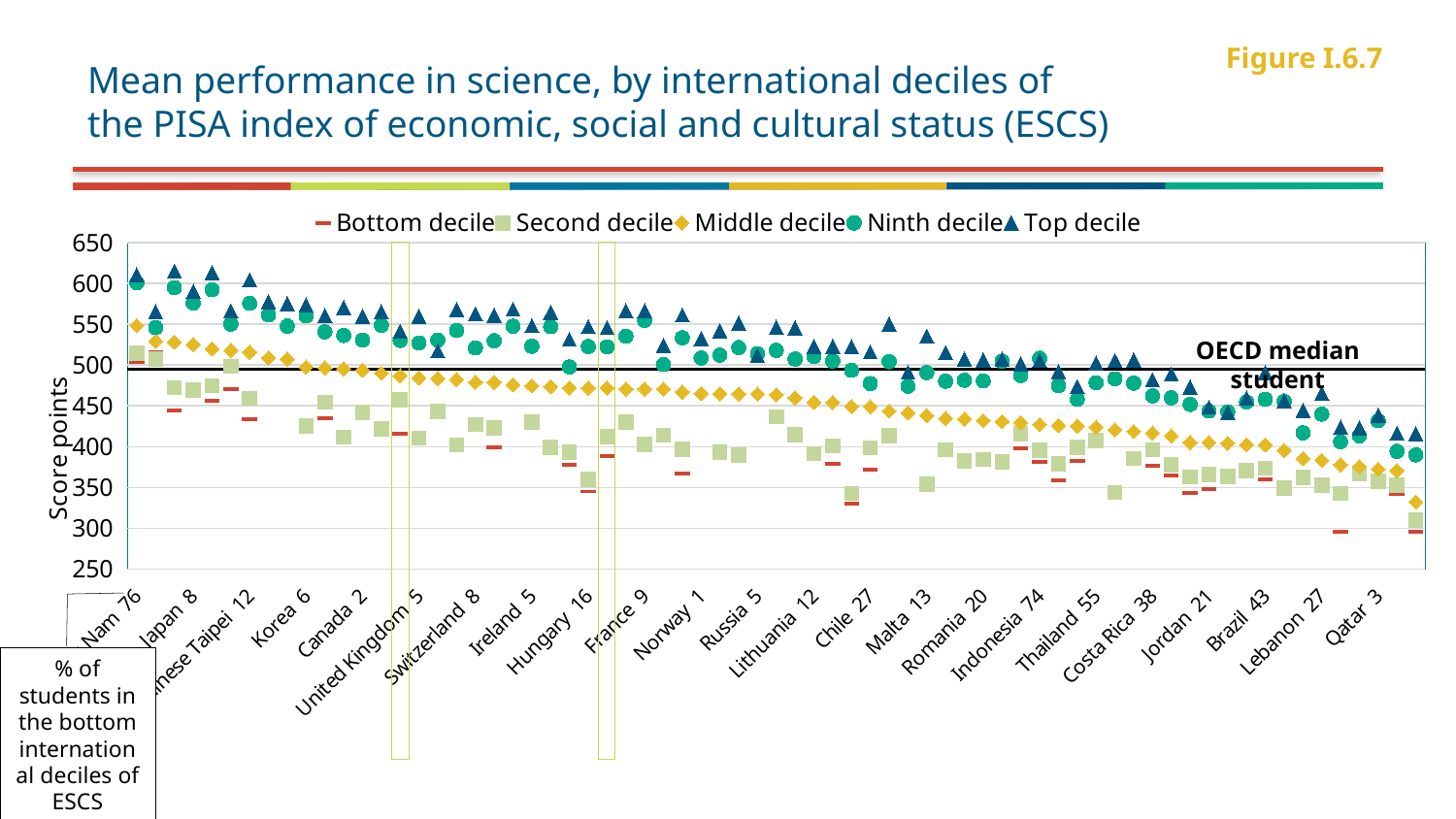
Which series does the legend list first? Bottom decile What kind of chart is shown on the slide? scatter (dot) chart Is the Bottom decile value for Chile greater or less than 350? greater Is the Top decile value for Korea greater or less than 550? greater Do the Top decile values generally rise or fall from left to right along the x axis? fall How many series does the legend list? 5 What does the horizontal black line across the chart represent? OECD median student Is the Second decile value for Japan greater or less than 500? less